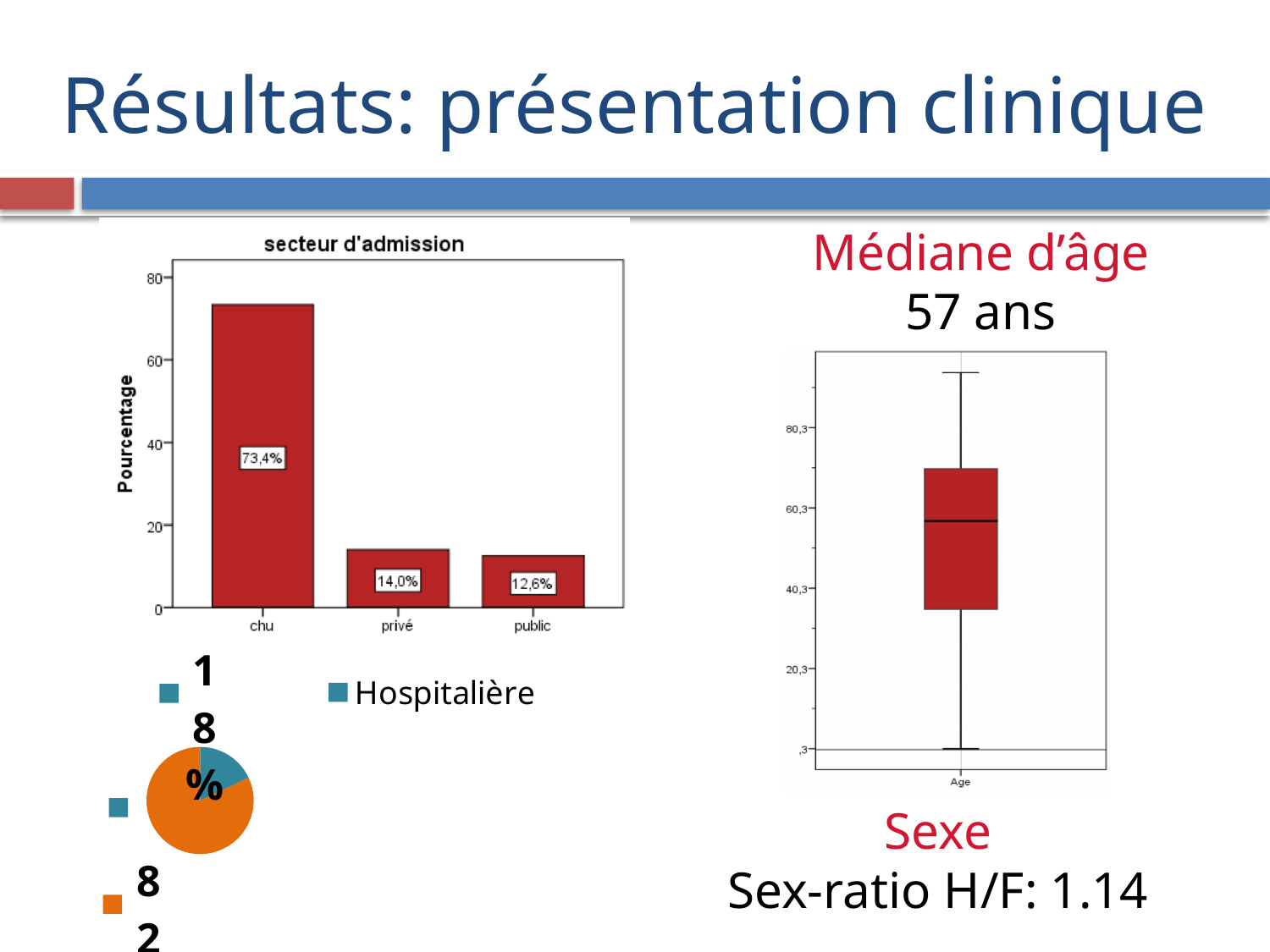
How many categories are shown in the 'secteur d'admission' bar chart? 3 In the 'secteur d'admission' bar chart, which category has the highest percentage? chu What kind of chart is the 'secteur d'admission' chart? bar chart In the 'secteur d'admission' bar chart, which category has the lowest percentage? public In the pie chart at the bottom left, what share does the Hospitalière slice represent? 18% In the 'secteur d'admission' bar chart, what is the value for chu? 73,4% What kind of chart is the 'Age' chart on the right of the slide? box plot In the 'secteur d'admission' bar chart, is the value for chu greater or less than 60? greater In the 'secteur d'admission' bar chart, what is the value for privé? 14,0% In the 'secteur d'admission' bar chart, what is the value for public? 12,6% In the 'secteur d'admission' bar chart, which is larger, the value for privé or the value for public? privé In the 'secteur d'admission' bar chart, what is the difference between the values for chu and privé? 59,4%